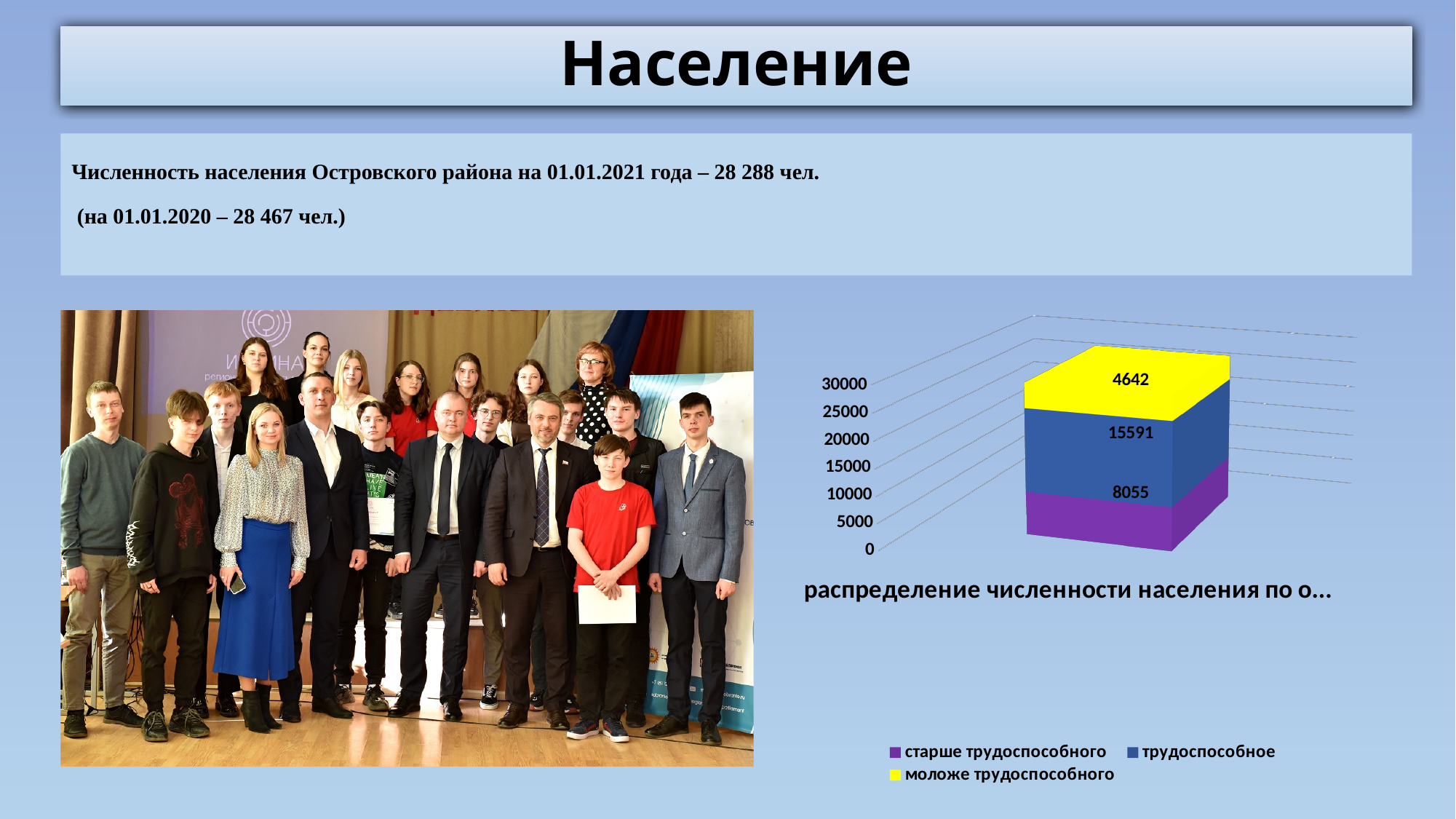
What is the value for the 'моложе трудоспособного' segment of the stacked bar? 4642 Which colour represents 'моложе трудоспособного' in the chart? yellow Which segment of the stacked bar has the smallest value? моложе трудоспособного What is the value for the 'трудоспособное' segment of the stacked bar? 15591 Which segment of the stacked bar has the largest value? трудоспособное What is the difference between the 'трудоспособное' and 'старше трудоспособного' values? 7536 What kind of chart is shown on the slide? stacked bar chart How many series does the chart legend list? 3 Which is larger: the 'старше трудоспособного' value or the 'моложе трудоспособного' value? старше трудоспособного What is the total of all segments in the stacked bar? 28288 What is the value for the 'старше трудоспособного' segment of the stacked bar? 8055 What is the difference between the 'старше трудоспособного' and 'моложе трудоспособного' values? 3413